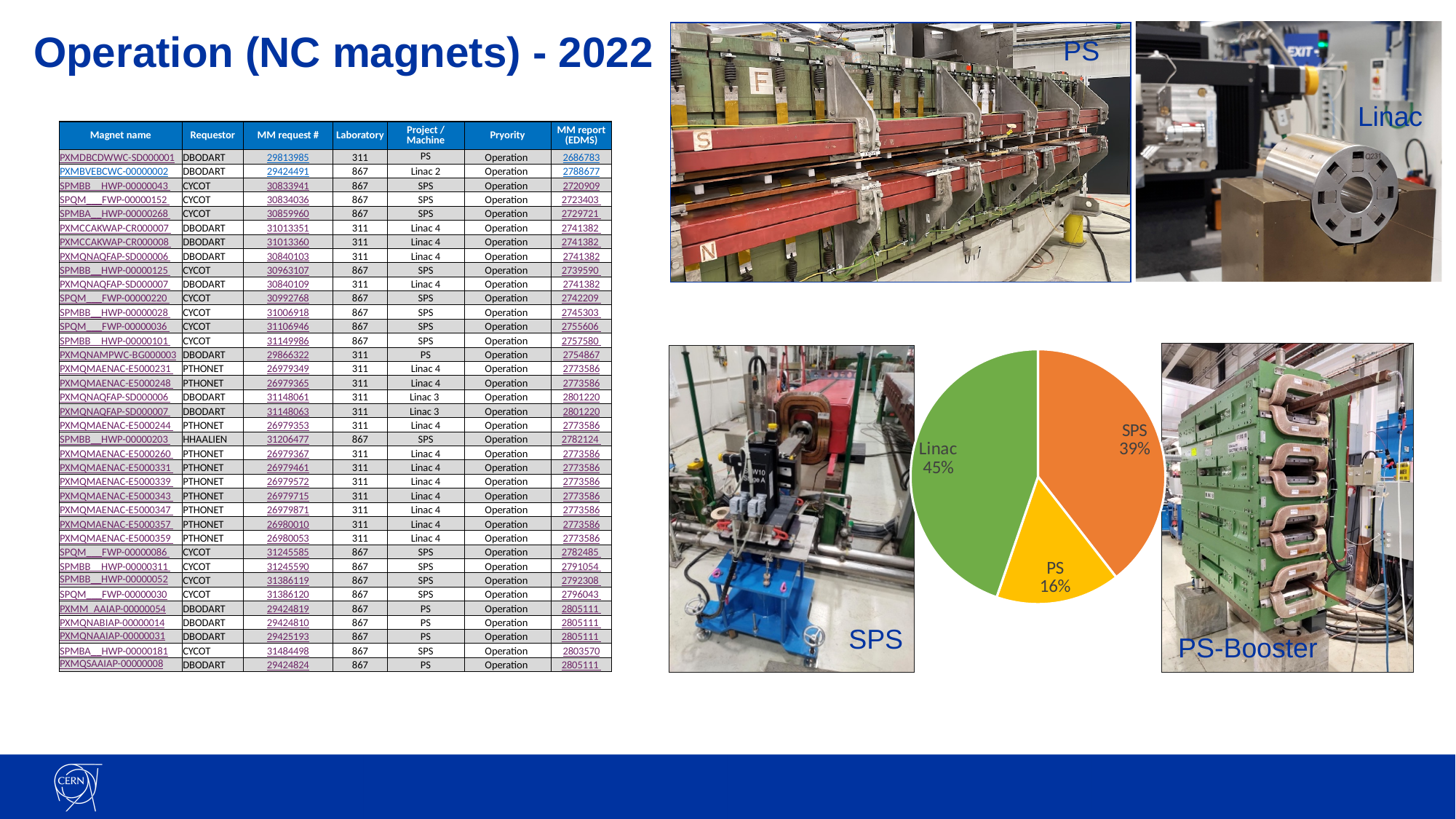
In the pie chart, what is the difference in percentage points between SPS and PS? 23 How many slices does the pie chart have? 3 Which slice of the pie chart is the smallest? PS What share of the pie chart does PS account for? 16% What share of the pie chart does Linac account for? 45% In the pie chart, what is the difference in percentage points between Linac and SPS? 6 In the pie chart, which is larger, SPS or PS? SPS Which slice of the pie chart is the largest? Linac What share of the pie chart does SPS account for? 39% What colour is the Linac slice in the pie chart? green What colour is the PS slice in the pie chart? yellow What kind of chart is shown on the slide? pie chart